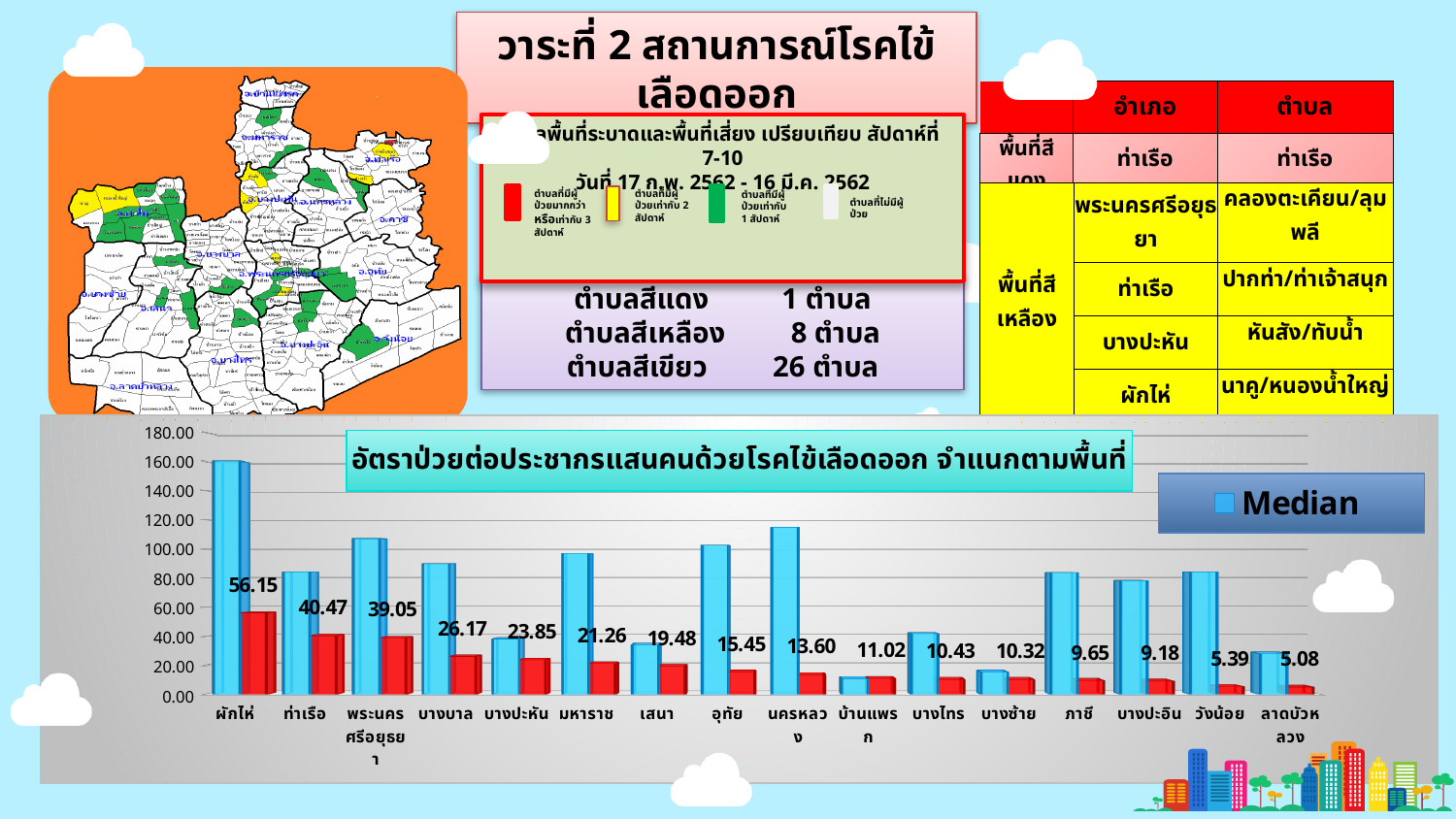
In the bar chart, is the Median value for ผักไห่ greater or less than 140? greater Do the labeled values in the bar chart rise or fall from left to right along the x axis? fall What is the title of the bar chart at the bottom of the slide? อัตราป่วยต่อประชากรแสนคนด้วยโรคไข้เลือดออก จำแนกตามพื้นที่ How many series does the legend of the bar chart list? 1 What type of chart is shown at the bottom of the slide? bar chart Which district has the lowest labeled value in the bar chart? ลาดบัวหลวง In the bar chart, what is the labeled value for ลาดบัวหลวง? 5.08 How many categories (districts) are shown on the x axis of the bar chart? 16 Which district has the highest labeled value in the bar chart? ผักไห่ In the bar chart, what is the labeled value for ผักไห่? 56.15 In the bar chart, what is the difference between the labeled values for ผักไห่ and ท่าเรือ? 15.68 In the bar chart, what is the labeled value for บางปะหัน? 23.85